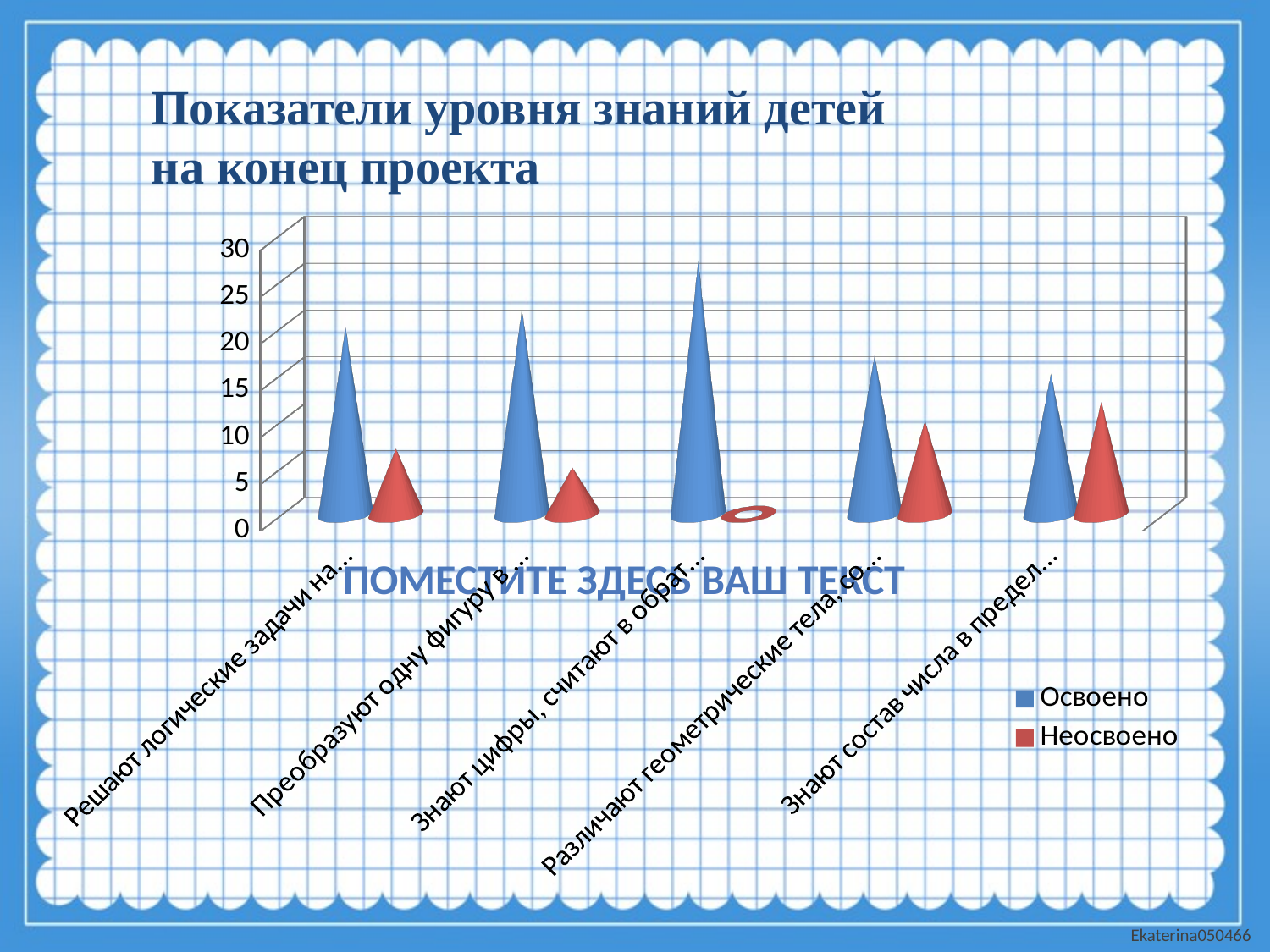
Which category has the highest value for Освоено? Знают цифры, считают в обрат... (third category) Which category has the lowest value for Неосвоено? Знают цифры, считают в обрат... (third category) What is the title of the chart? Показатели уровня знаний детей на конец проекта Is the Освоено value for the last category (Знают состав числа в предел...) greater or less than 20? less What kind of chart is shown on the slide? bar chart Is the Освоено value for the third category (Знают цифры, считают в обрат...) greater or less than 25? greater Which category has the highest value for Неосвоено? Знают состав числа в предел... (last category) How many categories are plotted along the x axis? 5 What are the two series named in the legend? Освоено, Неосвоено Is the Неосвоено value for the last category (Знают состав числа в предел...) greater or less than 10? greater For the first category (Решают логические задачи на...), which series has the larger value, Освоено or Неосвоено? Освоено How many series does the legend list? 2